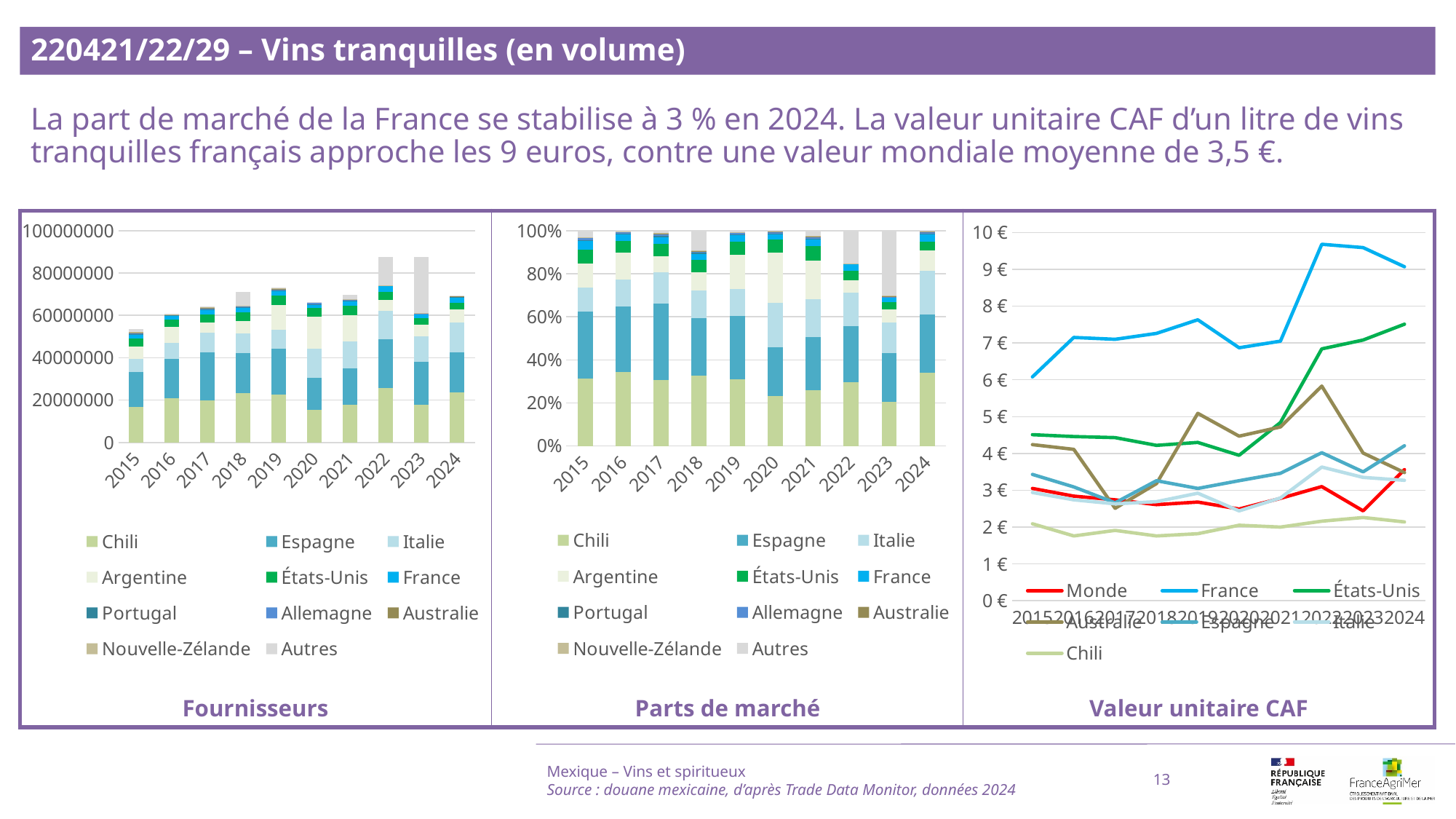
In the 'Valeur unitaire CAF' chart, is the value for France in 2022 greater or less than 9 €? greater In the 'Valeur unitaire CAF' chart, which series has the lowest value in 2024? Chili In the 'Valeur unitaire CAF' chart, which is larger in 2024: France or États-Unis? France How many series does the legend of the 'Valeur unitaire CAF' chart list? 7 How many series does the legend of the 'Parts de marché' chart list? 11 In the 'Valeur unitaire CAF' chart, does the France line rise or fall overall from 2015 to 2024? rise What kind of chart is the 'Fournisseurs' chart? bar chart In the 'Parts de marché' chart, is the share for Chili in 2024 greater or less than 20%? greater In the 'Fournisseurs' chart, how many years are shown on the x axis? 10 What kind of chart is the 'Valeur unitaire CAF' chart? line chart In the 'Fournisseurs' chart, is the total of the 2015 bar greater or less than 60000000? less In the 'Valeur unitaire CAF' chart, which series has the highest value in 2024? France